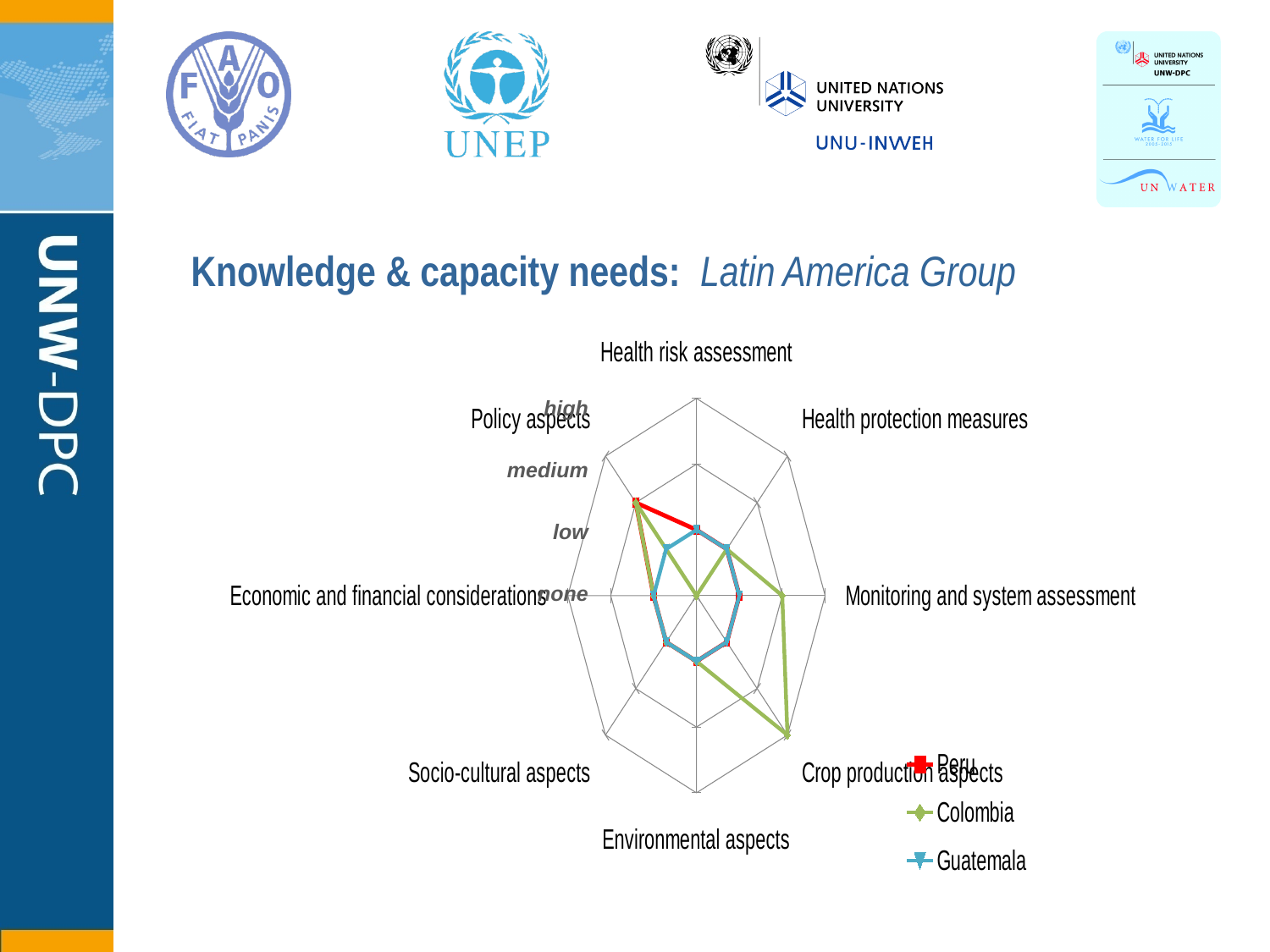
How many series does the legend of the chart list? 3 For Colombia, which category has the highest value? Crop production aspects What kind of chart is shown on the slide? Radar chart What are the four levels marked on the chart's scale, from the centre outward? none, low, medium, high For Colombia, which is larger: Crop production aspects or Socio-cultural aspects? Crop production aspects On Crop production aspects, which series has the larger value: Colombia or Guatemala? Colombia How many categories (axes) does the radar chart have? 8 For Colombia, which is larger: Policy aspects or Health risk assessment? Policy aspects Which series are listed in the chart's legend? Peru, Colombia, Guatemala